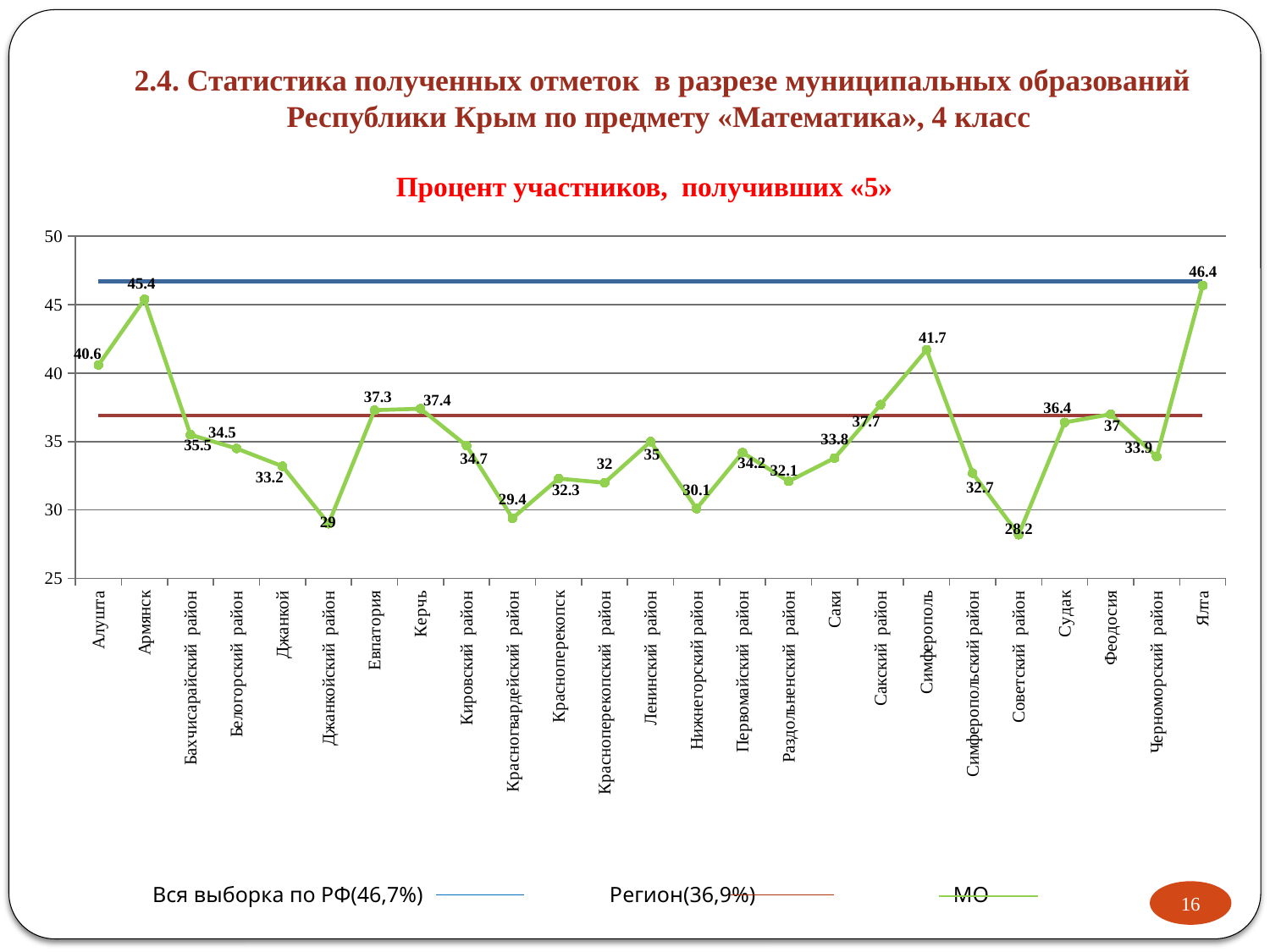
What is the value for Симферополь? 41.7 Is the value for Нижнегорский район greater or less than 35? less What is the value for Керчь? 37.4 Which municipality has the lowest percentage of participants receiving «5»? Советский район How many municipalities are plotted on the x axis? 25 What kind of chart is shown on the slide? line chart What value does the legend give for Регион? 36,9% Which is larger, the value for Армянск or the value for Алушта? Армянск What is the value for Джанкойский район? 29 Which municipality has the highest percentage of participants receiving «5»? Ялта How many series does the legend list? 3 What is the difference between the values for Ялта and Советский район? 18.2